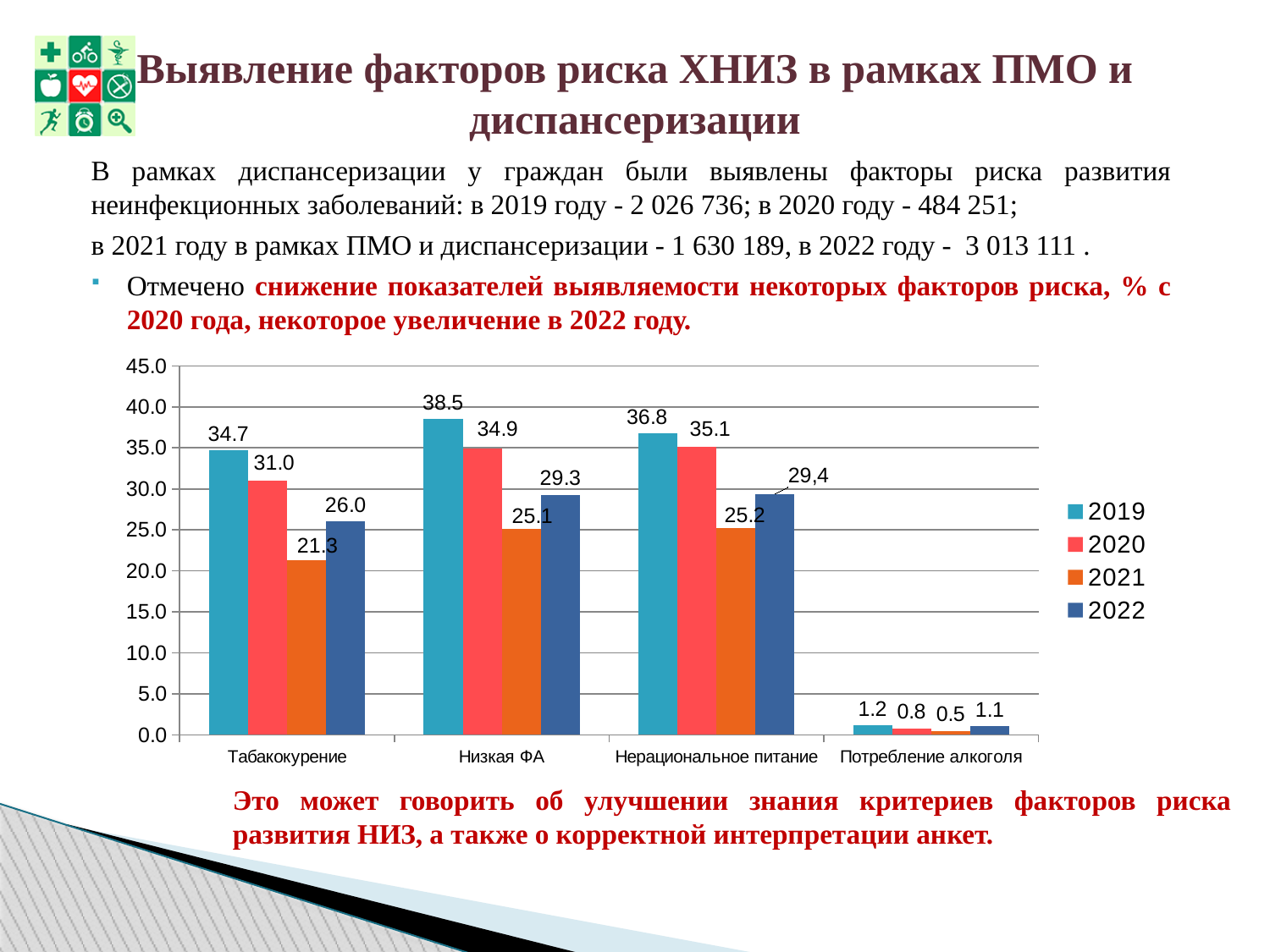
Which is larger for Низкая ФА: the 2020 value or the 2022 value? 2020 How many categories are shown on the x axis of the chart? 4 Which category has the highest value in 2019? Низкая ФА What is the difference between the 2019 and 2021 values for Табакокурение? 13.4 What is the value for Нерациональное питание in 2020? 35.1 What type of chart is shown on the slide? bar chart What is the value for Потребление алкоголя in 2022? 1.1 What is the value for Низкая ФА in 2021? 25.1 How many series does the chart legend list? 4 Do the values for Нерациональное питание rise or fall from 2019 to 2021? fall Which category has the lowest value in 2021? Потребление алкоголя What is the value for Табакокурение in 2019? 34.7